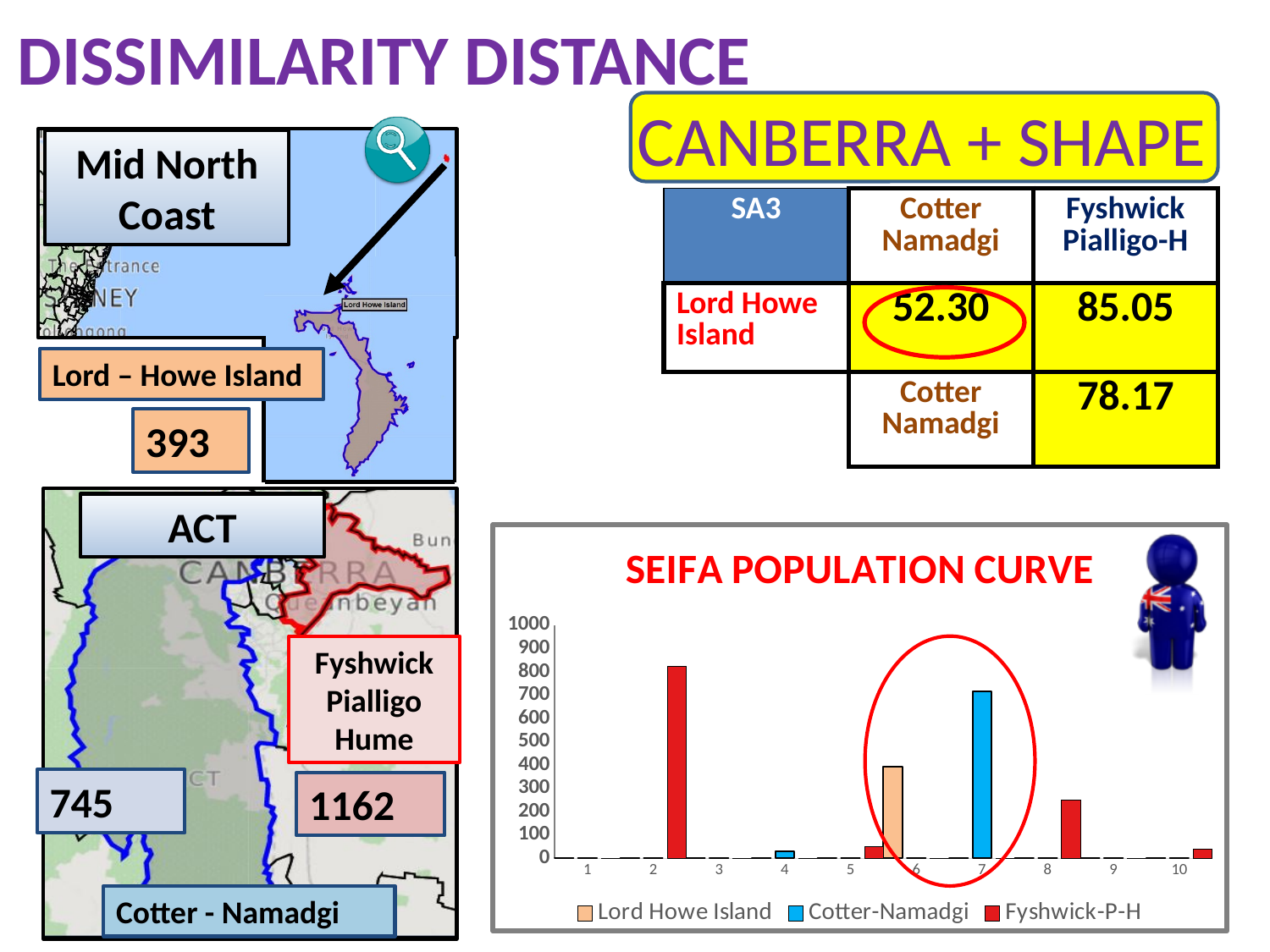
In the SEIFA POPULATION CURVE chart, is the Cotter-Namadgi value at category 7 greater or less than 500? greater In the SEIFA POPULATION CURVE chart, which colour represents the Cotter-Namadgi series? blue In the SEIFA POPULATION CURVE chart, at which x-axis category does the Fyshwick-P-H series have its highest bar? 2 In the SEIFA POPULATION CURVE chart, is the Fyshwick-P-H value at category 2 greater or less than 500? greater How many categories are shown on the x axis of the SEIFA POPULATION CURVE chart? 10 How many series does the legend of the SEIFA POPULATION CURVE chart list? 3 What is the title of the bar chart on the slide? SEIFA POPULATION CURVE In the SEIFA POPULATION CURVE chart, is the Fyshwick-P-H value at category 8 greater or less than 500? less In the SEIFA POPULATION CURVE chart, which is larger: the Cotter-Namadgi bar at category 7 or the Lord Howe Island bar at category 6? Cotter-Namadgi at category 7 What kind of chart is the SEIFA POPULATION CURVE chart? bar chart In the SEIFA POPULATION CURVE chart, which is larger: the Fyshwick-P-H bar at category 2 or the Cotter-Namadgi bar at category 7? Fyshwick-P-H at category 2